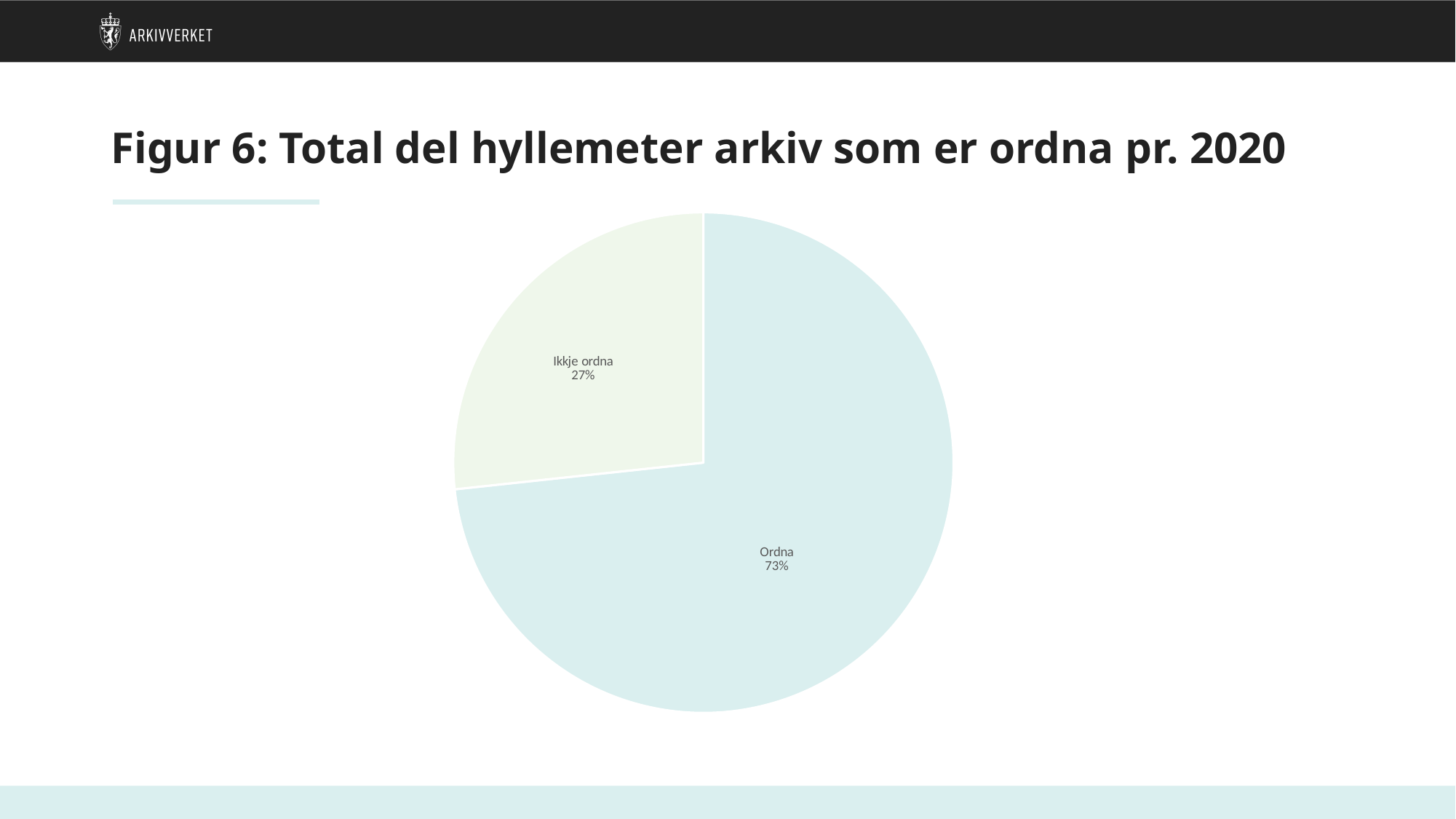
What is the title of the chart on the slide? Figur 6: Total del hyllemeter arkiv som er ordna pr. 2020 Which slice is the smallest in the pie chart? Ikkje ordna How many slices does the pie chart have? 2 What is the difference in percentage points between the "Ordna" and "Ikkje ordna" slices? 46 What share of the pie does the "Ordna" slice represent? 73% What share of the pie does the "Ikkje ordna" slice represent? 27% What is the total of the two slice percentages shown in the pie chart? 100% What kind of chart is shown on the slide? pie chart Which is larger, the "Ordna" slice or the "Ikkje ordna" slice? Ordna Which slice is the largest in the pie chart? Ordna